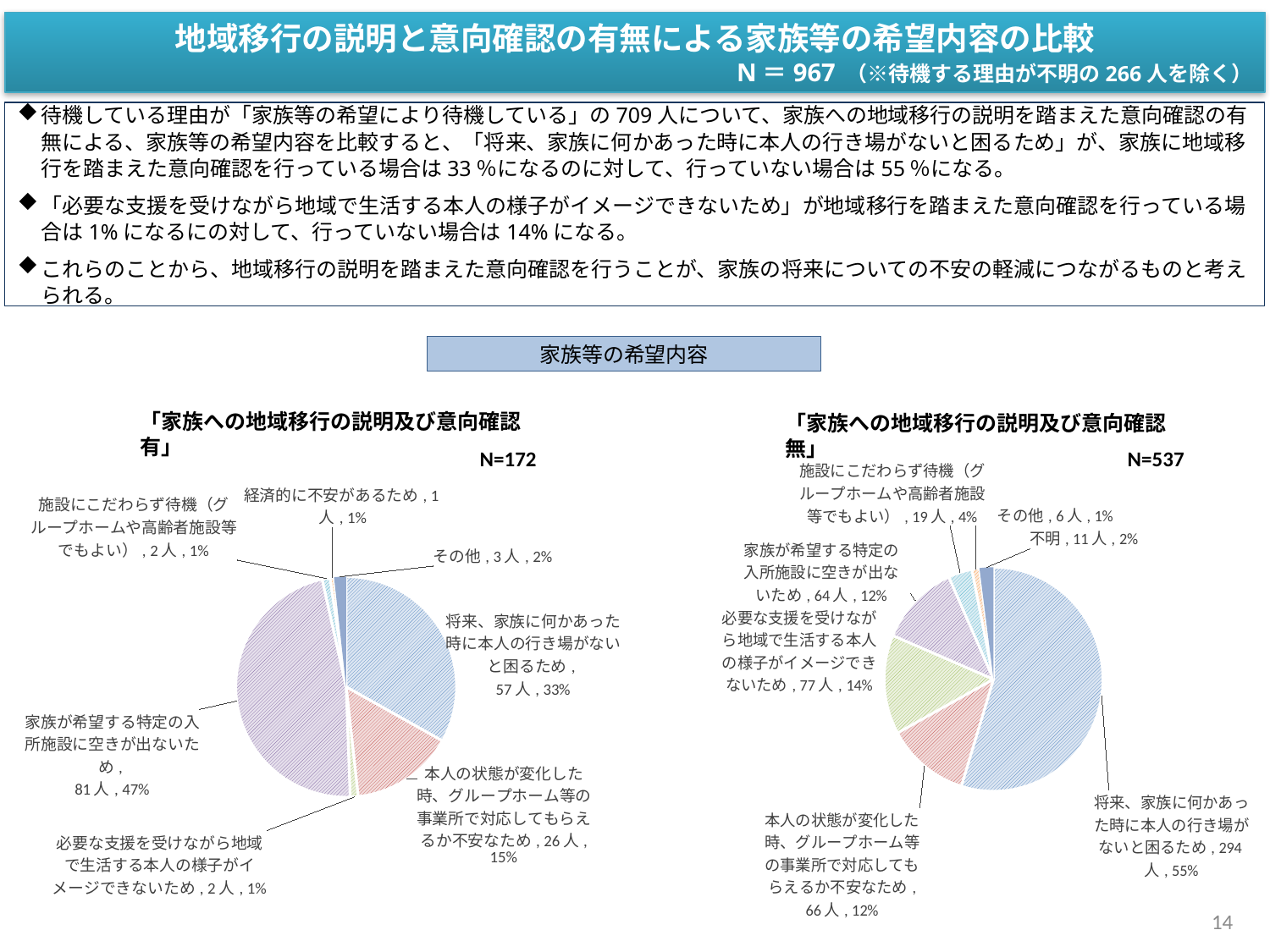
このスライドの2つのグラフはどのような種類のグラフですか？ 円グラフ 右の円グラフ「家族への地域移行の説明及び意向確認 無」で、最も人数が少ない項目はどれですか？ その他 左の円グラフ「家族への地域移行の説明及び意向確認 有」で、「将来、家族に何かあった時に本人の行き場がないと困るため」と「本人の状態が変化した時、グループホーム等の事業所で対応してもらえるか不安なため」では、どちらの人数が多いですか？ 将来、家族に何かあった時に本人の行き場がないと困るため 右の円グラフ「家族への地域移行の説明及び意向確認 無」には、いくつの項目（スライス）がありますか？ 7 右の円グラフ「家族への地域移行の説明及び意向確認 無」で、「将来、家族に何かあった時に本人の行き場がないと困るため」の割合は何%ですか？ 55% 右の円グラフ「家族への地域移行の説明及び意向確認 無」で、「不明」の人数は何人ですか？ 11人 左の円グラフ「家族への地域移行の説明及び意向確認 有」で、最も割合が大きい項目はどれですか？ 家族が希望する特定の入所施設に空きが出ないため 左の円グラフ「家族への地域移行の説明及び意向確認 有」で、「家族が希望する特定の入所施設に空きが出ないため」の人数は何人ですか？ 81人 左の円グラフ「家族への地域移行の説明及び意向確認 有」には、いくつの項目（スライス）がありますか？ 7 右の円グラフ「家族への地域移行の説明及び意向確認 無」で、「施設にこだわらず待機（グループホームや高齢者施設等でもよい）」の割合は何%ですか？ 4% 右の円グラフ「家族への地域移行の説明及び意向確認 無」で、「必要な支援を受けながら地域で生活する本人の様子がイメージできないため」と「本人の状態が変化した時、グループホーム等の事業所で対応してもらえるか不安なため」の人数の差は何人ですか？ 11人 左の円グラフ「家族への地域移行の説明及び意向確認 有」のNはいくつですか？ N=172